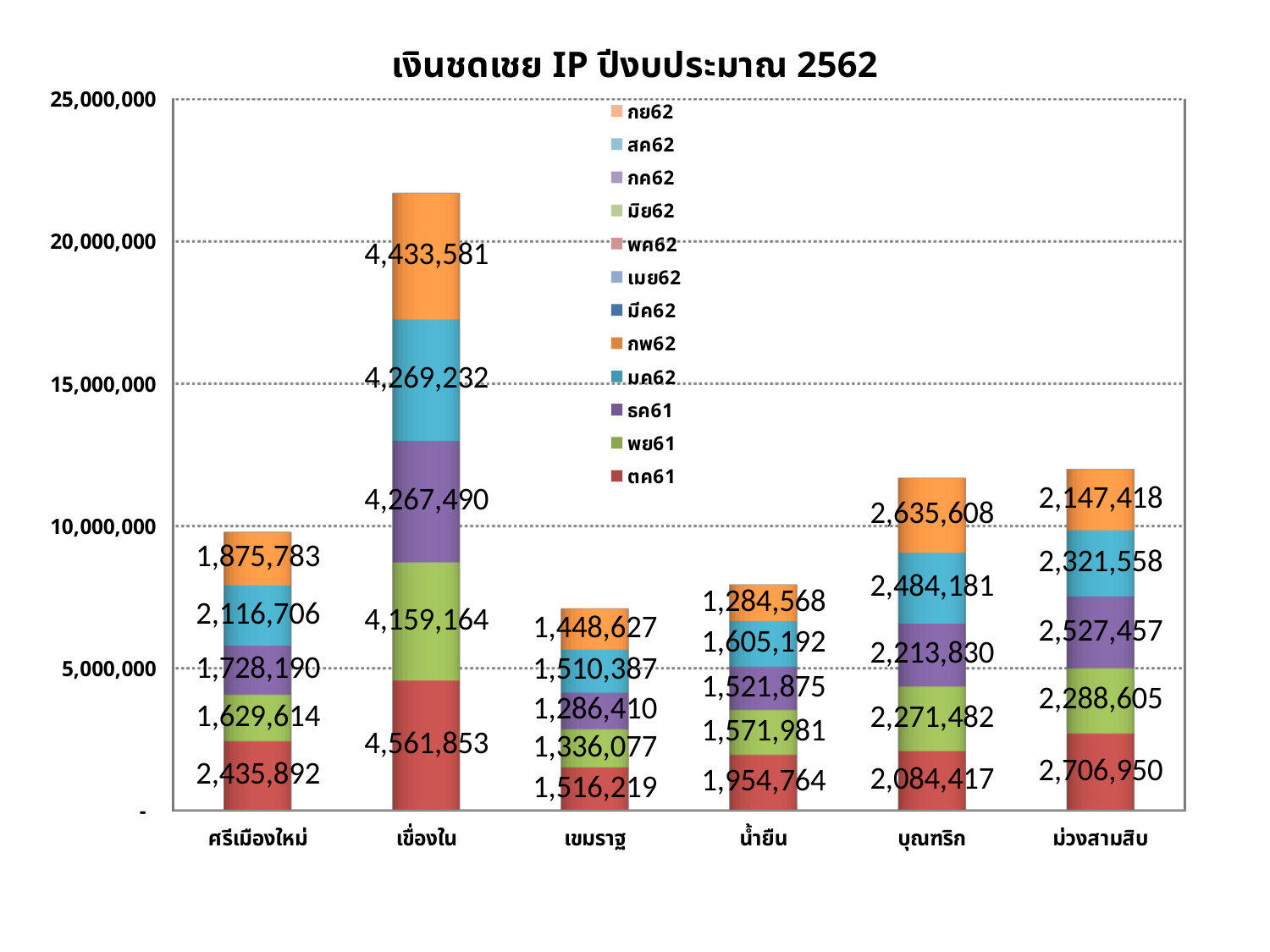
Is the total stacked bar for เขื่องใน greater or less than 20,000,000? greater What is the difference between the ตค61 values for ม่วงสามสิบ and น้ำยืน? 752,186 What is the value of the กพ62 segment for บุณฑริก? 2,635,608 Which category has the highest total stacked bar? เขื่องใน Which is larger, the พย61 value for บุณฑริก or the พย61 value for ม่วงสามสิบ? ม่วงสามสิบ What is the title of the chart? เงินชดเชย IP ปีงบประมาณ 2562 Which category has the lowest total stacked bar? เขมราฐ How many series does the legend list? 12 What is the value of the มค62 segment for ศรีเมืองใหม่? 2,116,706 What is the value of the ตค61 segment for เขื่องใน? 4,561,853 How many categories are shown on the x axis? 6 What type of chart is shown on the slide? Stacked bar chart